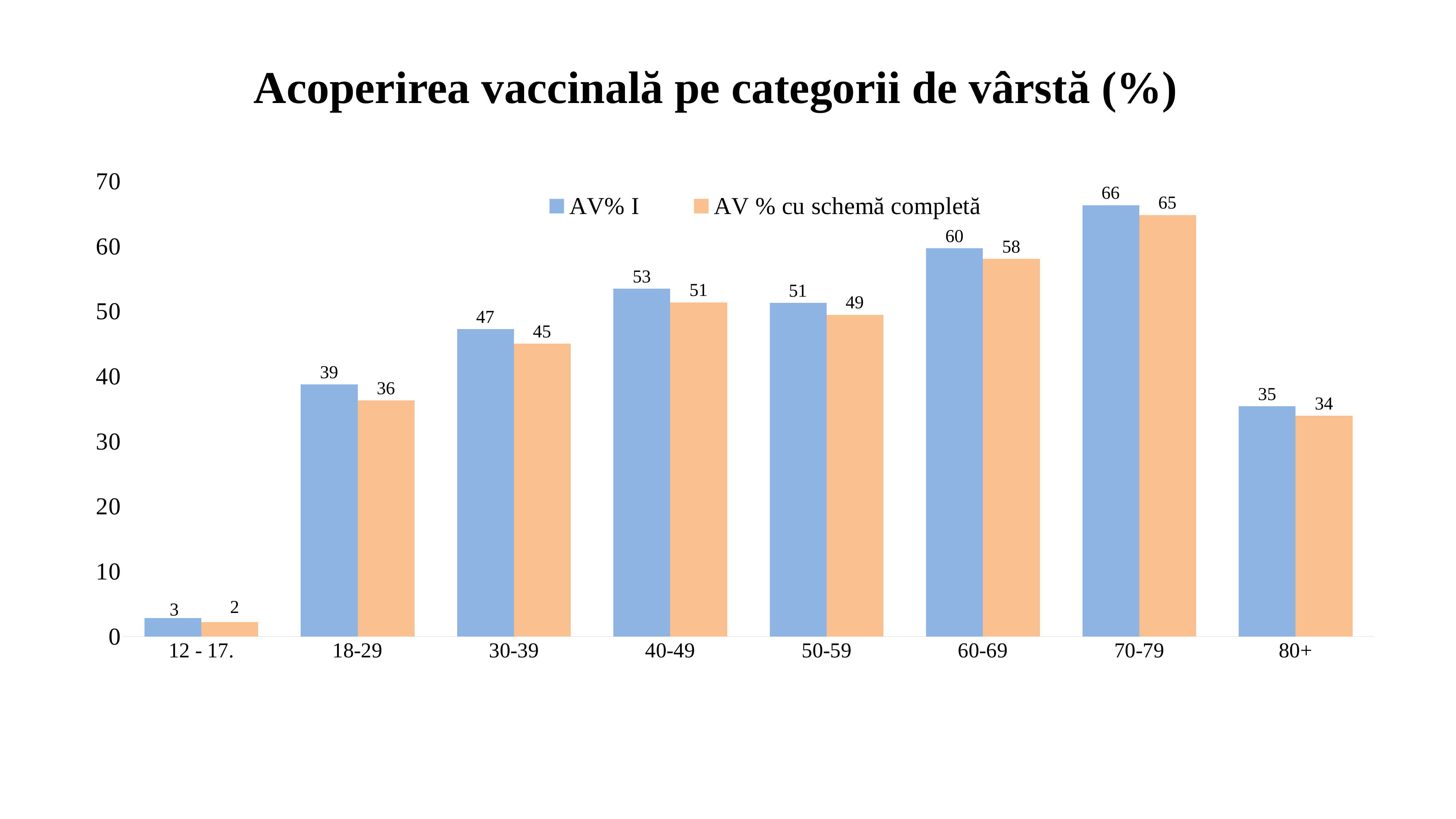
What is the AV% I value for the 40-49 age group? 53 Which is larger for the 60-69 age group: AV% I or AV % cu schemă completă? AV% I What kind of chart is shown on the slide? bar chart Which age group has the highest AV% I value? 70-79 How many series does the legend list? 2 How many age groups are shown on the x axis? 8 What is the AV % cu schemă completă value for the 18-29 age group? 36 Is the AV% I value for the 30-39 age group greater or less than 40? greater What is the difference between the AV% I and AV % cu schemă completă values for the 18-29 age group? 3 What is the title of the chart? Acoperirea vaccinală pe categorii de vârstă (%) Do the AV% I values rise or fall from the 12 - 17. group to the 70-79 group? rise Which age group has the lowest AV % cu schemă completă value? 12 - 17.